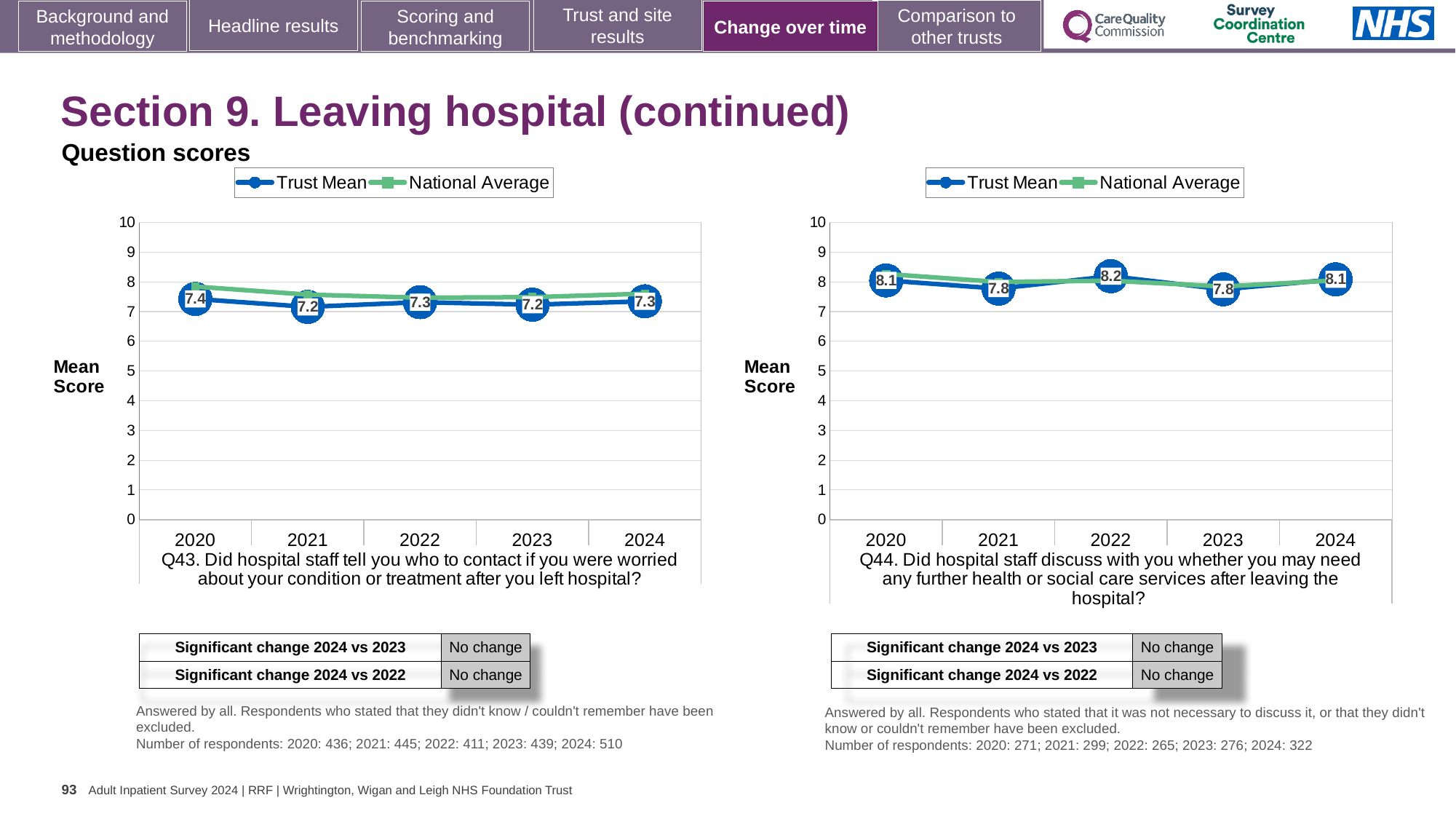
In the Q44 chart on the right, what is the Trust Mean score for 2021? 7.8 How many series does the legend of the Q43 chart on the left list? 2 In the Q44 chart on the right, what is the difference between the Trust Mean scores for 2022 and 2023? 0.4 In the Q43 chart on the left, is the National Average value for 2020 greater or less than 7? greater In the Q44 chart on the right, what is the Trust Mean score for 2022? 8.2 In the Q44 chart on the right, which year has the highest Trust Mean score? 2022 In the Q43 chart on the left, what is the Trust Mean score for 2024? 7.3 How many years are plotted on the x axis of the Q44 chart on the right? 5 In the Q43 chart on the left, which year has the highest Trust Mean score? 2020 In the Q43 chart on the left, is the Trust Mean score for 2020 or 2021 larger? 2020 What type of chart is the Q44 chart on the right? Line chart In the Q43 chart on the left, what is the Trust Mean score for 2020? 7.4